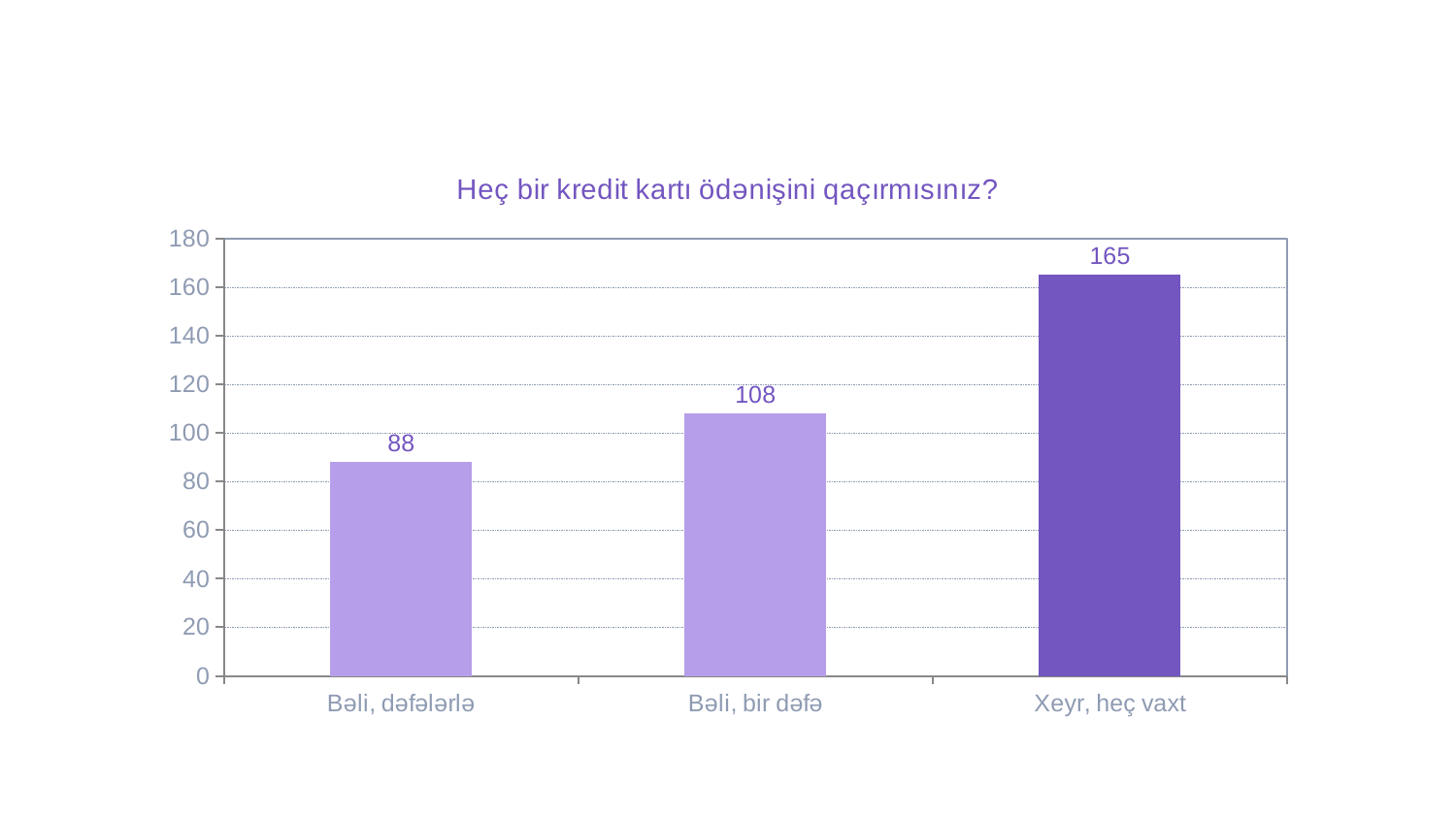
Which is larger, the value for "Bəli, bir dəfə" or the value for "Bəli, dəfələrlə"? Bəli, bir dəfə Which category has the lowest value? Bəli, dəfələrlə How many categories are shown on the x axis? 3 What kind of chart is shown on the slide? bar chart Is the value for "Xeyr, heç vaxt" greater or less than 140? greater Which category has the highest value? Xeyr, heç vaxt What is the value for "Xeyr, heç vaxt"? 165 What is the value for "Bəli, dəfələrlə"? 88 What is the title of the chart? Heç bir kredit kartı ödənişini qaçırmısınız? What is the difference between the values for "Xeyr, heç vaxt" and "Bəli, bir dəfə"? 57 What is the value for "Bəli, bir dəfə"? 108 What is the difference between the values for "Bəli, bir dəfə" and "Bəli, dəfələrlə"? 20